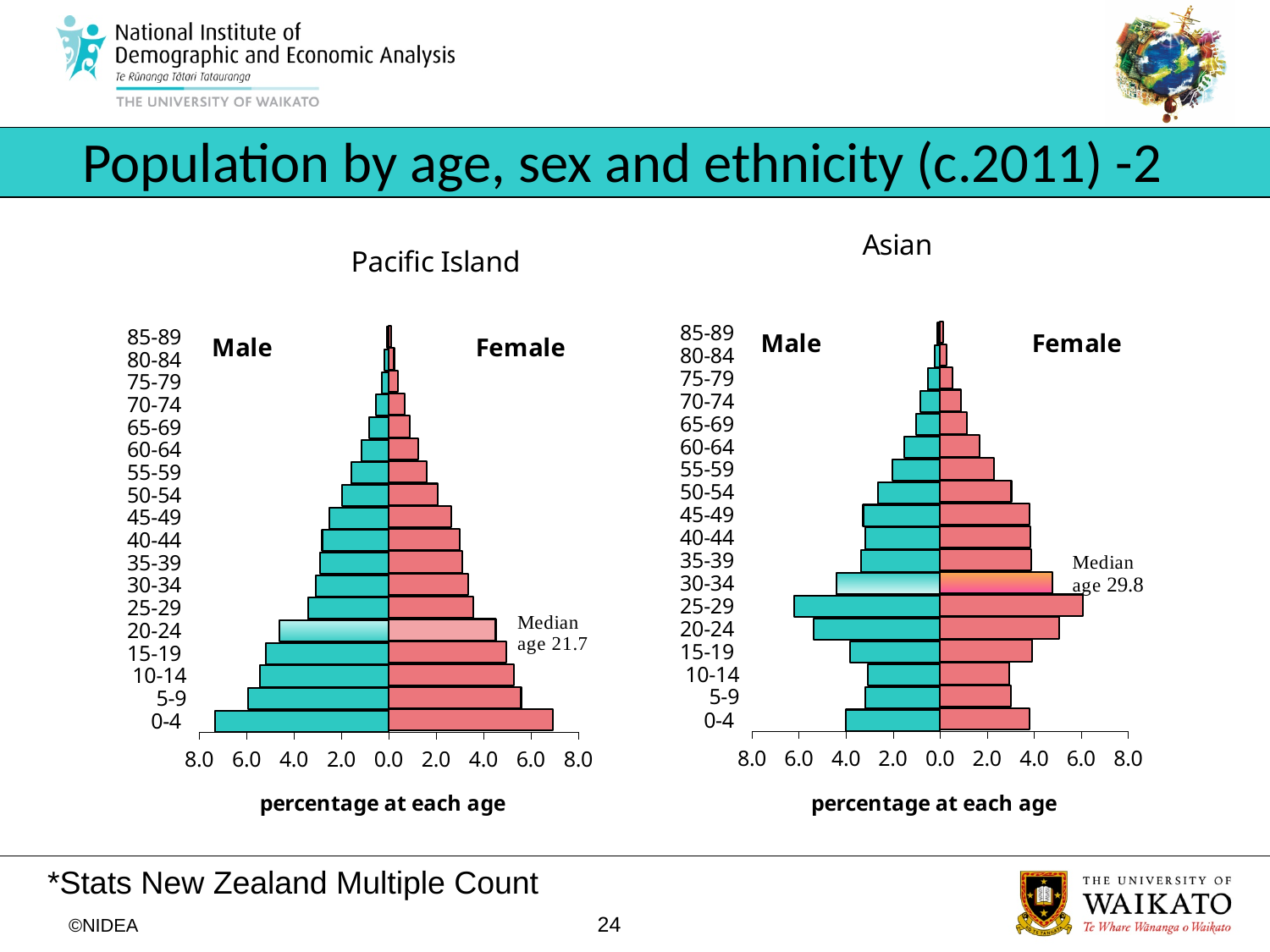
In the Pacific Island chart, what is the median age shown? 21.7 In the Pacific Island chart, which age group has the largest male bar? 0-4 What is the x-axis label on the Asian chart? percentage at each age In the Asian chart, is the male value for the 10-14 age group greater or less than 4.0? less In the Pacific Island chart, is the male value for the 0-4 age group greater or less than 6.0? greater In the Asian chart, which age group has the largest female bar? 25-29 What kind of chart is the Pacific Island chart? bar chart (population pyramid) In the Asian chart, which age group has the smallest bars? 85-89 How many age groups are shown on the vertical axis of the Pacific Island chart? 18 What is the difference between the median age in the Asian chart and the median age in the Pacific Island chart? 8.1 Which is larger: the male 0-4 bar in the Pacific Island chart or the male 0-4 bar in the Asian chart? Pacific Island In the Asian chart, what is the median age shown? 29.8